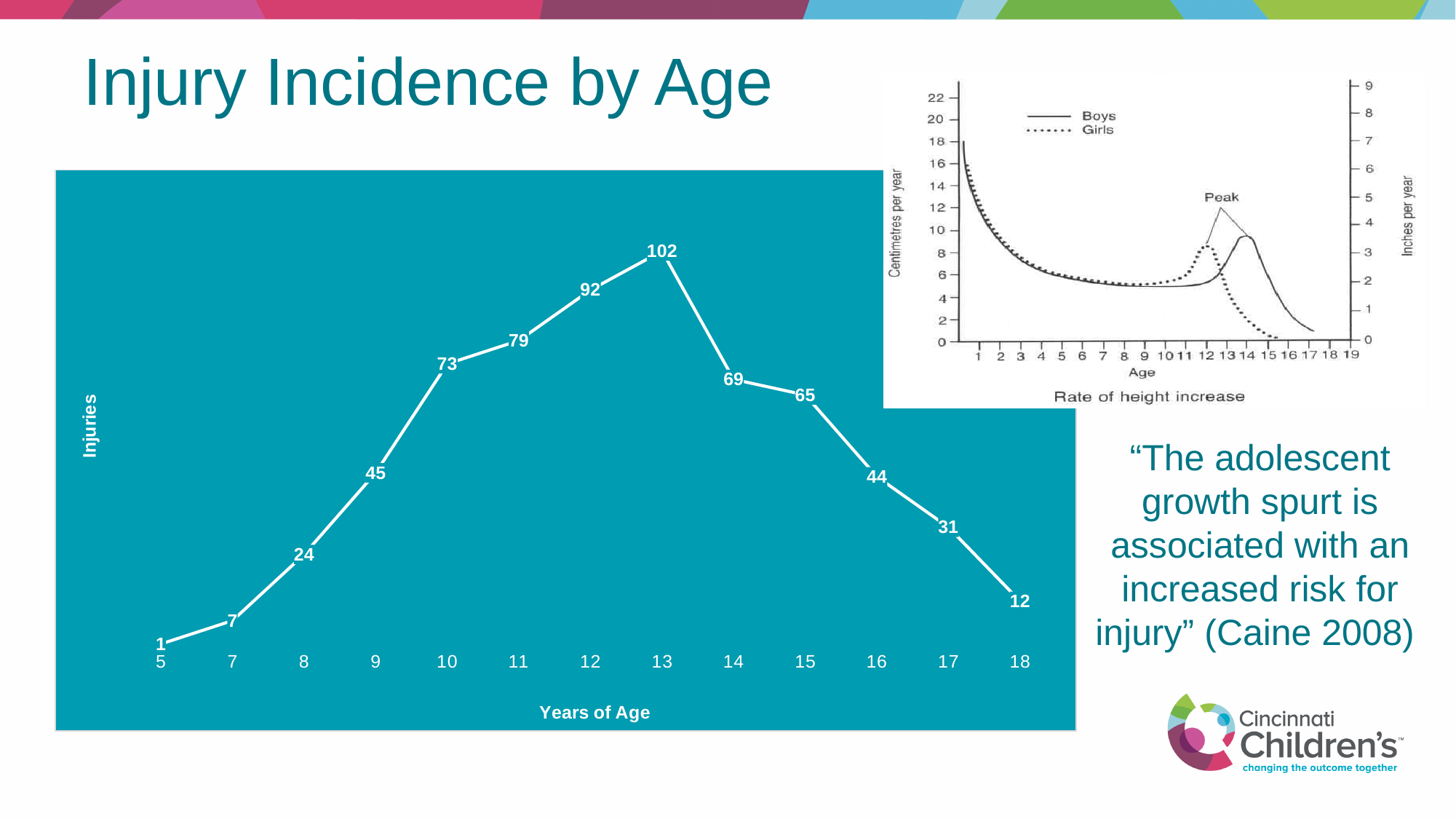
On the Rate of height increase chart, how many series does the legend list? 2 On the Injury Incidence by Age chart, how many injuries are recorded at 13 years of age? 102 What kind of chart is the Injury Incidence by Age chart? line chart On the Injury Incidence by Age chart, how many age points are plotted? 13 On the Injury Incidence by Age chart, do injuries rise or fall from age 13 to age 18? fall On the Injury Incidence by Age chart, which has more injuries, age 12 or age 15? 12 On the Injury Incidence by Age chart, what is the label of the x axis? Years of Age On the Injury Incidence by Age chart, which age has the highest number of injuries? 13 On the Injury Incidence by Age chart, what is the difference between the injuries at age 13 and at age 14? 33 On the Rate of height increase chart, is the Boys value at age 14 greater or less than 8 centimetres per year? greater On the Injury Incidence by Age chart, what is the value at 10 years of age? 73 On the Injury Incidence by Age chart, which age has the lowest number of injuries? 5